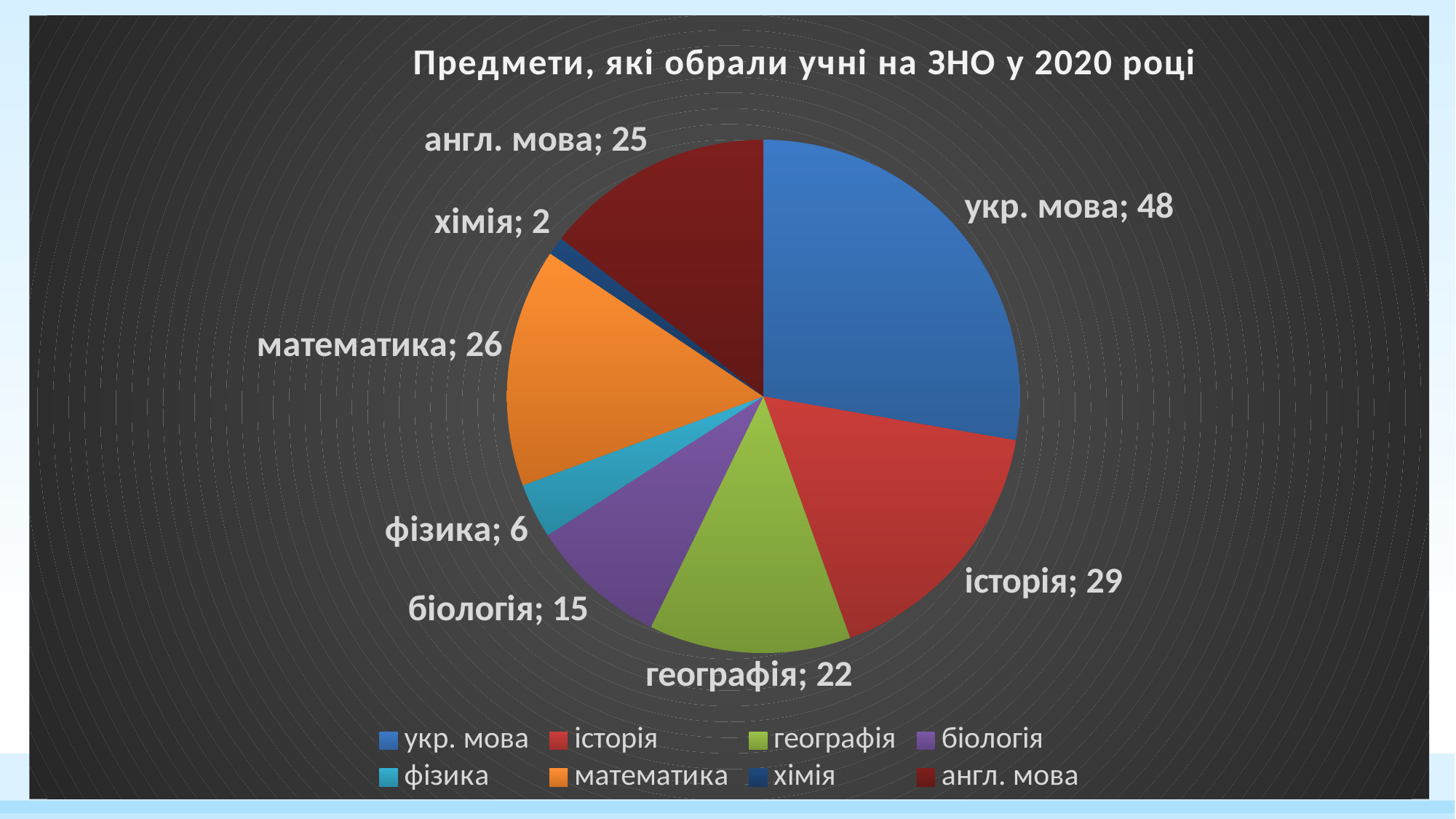
What is the difference between the values for укр. мова and англ. мова? 23 Which is larger, the value for біологія or the value for фізика? біологія What is the title of the chart? Предмети, які обрали учні на ЗНО у 2020 році Which subject has the largest slice? укр. мова How many subjects are shown in the pie chart? 8 Which subject has the smallest slice? хімія What is the total of all values in the pie chart? 173 What is the value for хімія? 2 What kind of chart is shown on the slide? pie chart What is the difference between the values for історія and географія? 7 What is the value for математика? 26 What is the value for укр. мова? 48